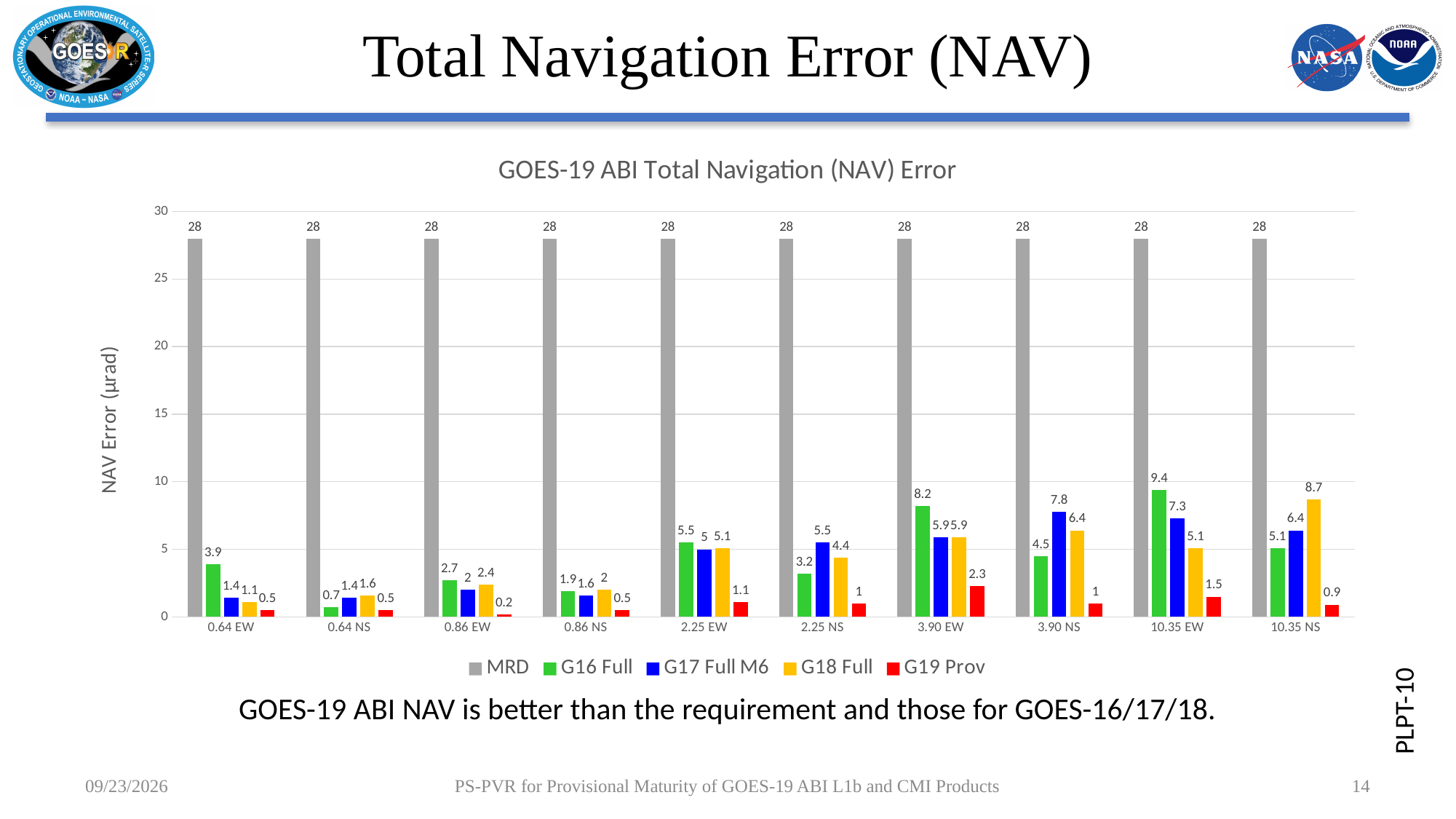
How many categories are shown on the x axis? 10 What is the G18 Full value for 10.35 NS? 8.7 What kind of chart is shown on the slide? Bar chart How many series does the legend list? 5 What is the title of the chart? GOES-19 ABI Total Navigation (NAV) Error Which category has the highest G17 Full M6 value? 3.90 NS What is the G16 Full value for 10.35 EW? 9.4 Which category has the lowest G19 Prov value? 0.86 EW What is the difference between the G16 Full and G19 Prov values for 3.90 EW? 5.9 For 10.35 NS, which is larger: the G17 Full M6 value or the G16 Full value? G17 Full M6 What is the G19 Prov value for 3.90 EW? 2.3 What is the MRD value for 2.25 NS? 28